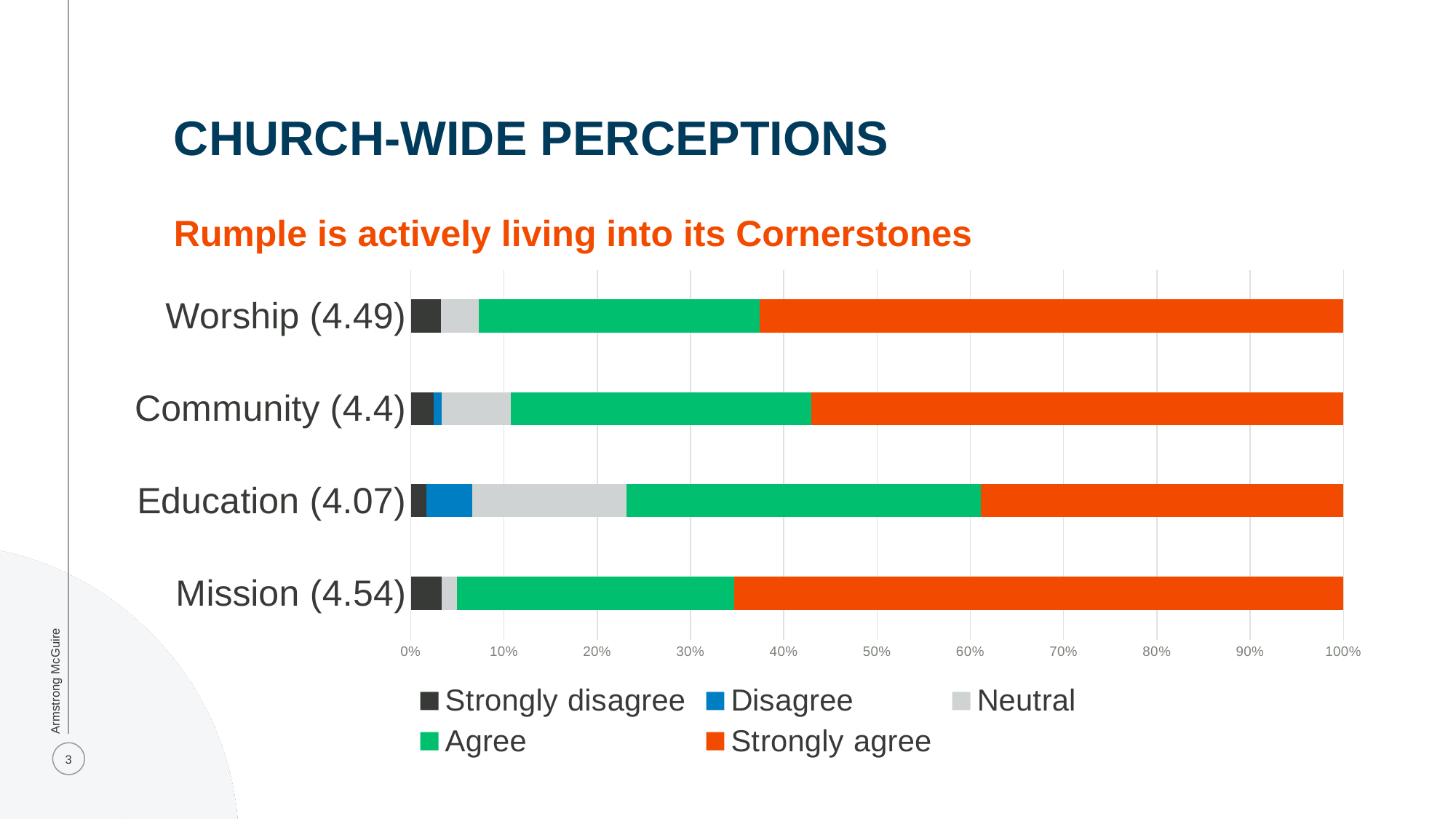
Which series is shown in orange in the legend? Strongly agree What kind of chart is shown on the slide? Stacked bar chart How many series does the legend list? 5 Is the Strongly agree share for Education greater or less than 50%? less What score is shown in parentheses next to Education? 4.07 Is the Strongly agree share for Mission greater or less than 60%? greater Which category has the smallest Strongly agree share? Education How many categories are plotted on the chart? 4 Which category has the largest Neutral share? Education What score is shown in parentheses next to Mission? 4.54 Which category has the highest score shown in parentheses? Mission (4.54) Which category has the lowest score shown in parentheses? Education (4.07)